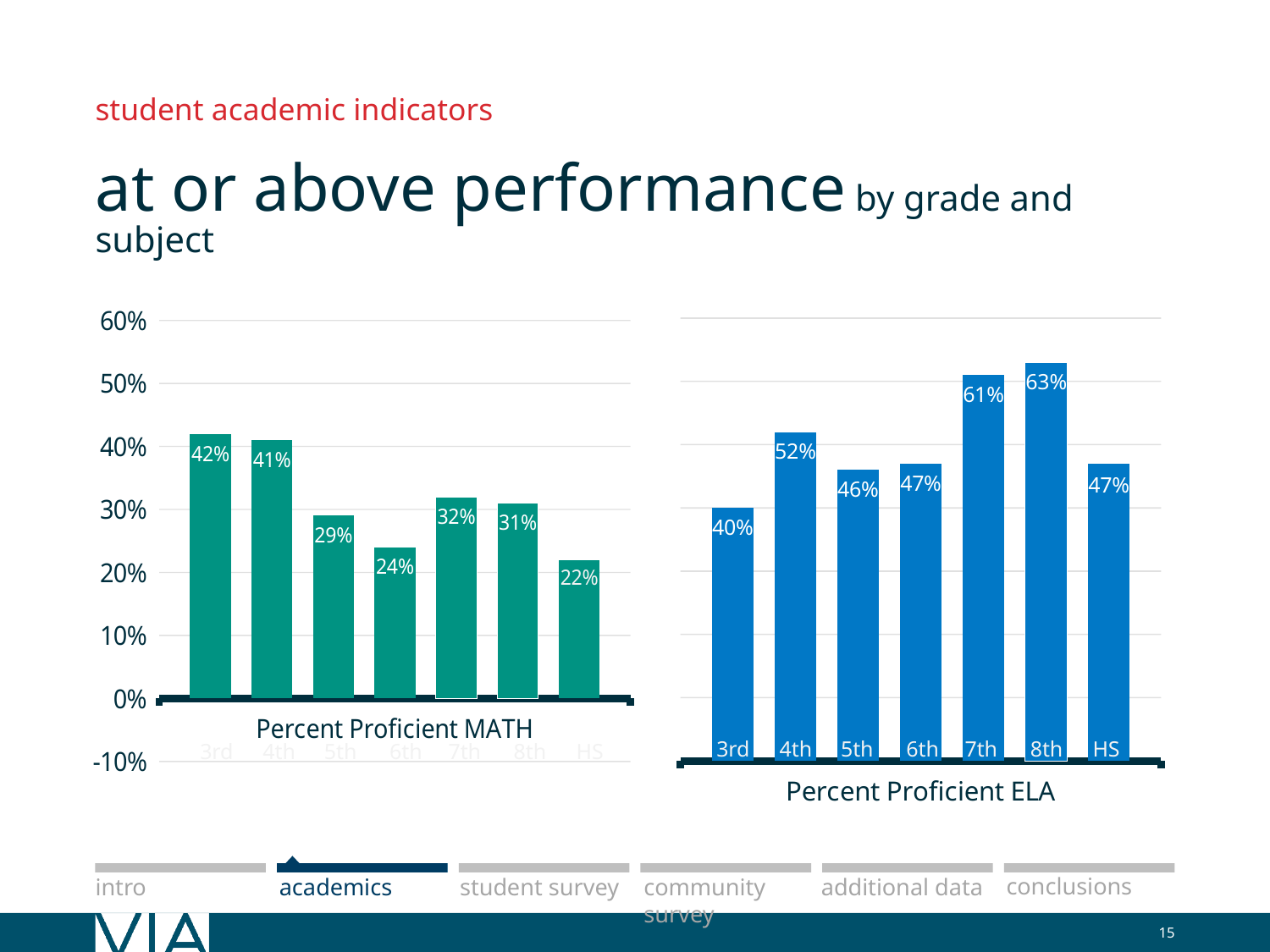
In the Percent Proficient ELA chart, what is the difference between the 8th grade value and the 3rd grade value? 23% What is the title of the chart on the right side of the slide? Percent Proficient ELA In the Percent Proficient MATH chart, what is the value for 3rd grade? 42% In the Percent Proficient ELA chart, which grade has the highest value? 8th In the Percent Proficient ELA chart, what is the value for HS? 47% In the Percent Proficient ELA chart, what is the value for 7th grade? 61% In the Percent Proficient MATH chart, which grade has the lowest value? HS How many bars are in the Percent Proficient ELA chart? 7 In the Percent Proficient ELA chart, which grade has the lowest value? 3rd Which is larger: the 6th grade value in the Percent Proficient MATH chart or the 6th grade value in the Percent Proficient ELA chart? Percent Proficient ELA What type of chart is the Percent Proficient MATH chart? Bar chart In the Percent Proficient MATH chart, what is the difference between the 3rd grade value and the HS value? 20%